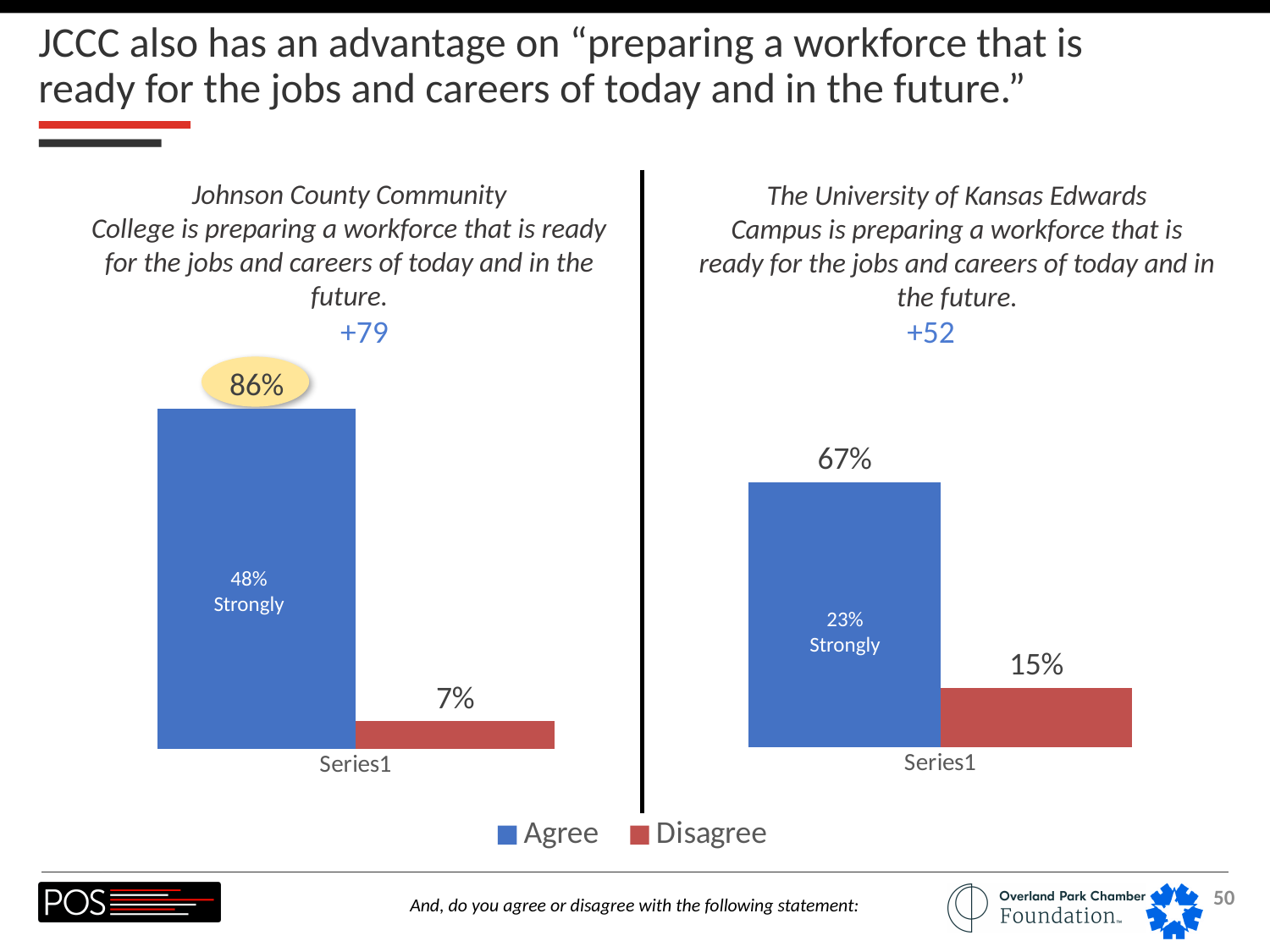
What kind of chart is used on this slide? Bar chart In the left chart (Johnson County Community College), what is the difference between the Agree and Disagree percentages? 79 percentage points In the right chart (The University of Kansas Edwards Campus), what percentage strongly agree? 23% In the right chart (The University of Kansas Edwards Campus), what percentage agree? 67% In the right chart (The University of Kansas Edwards Campus), what percentage disagree? 15% Which chart shows the higher Agree percentage, the left (Johnson County Community College) or the right (The University of Kansas Edwards Campus)? The left (Johnson County Community College) In the right chart (The University of Kansas Edwards Campus), which is larger, Agree or Disagree? Agree In the right chart (The University of Kansas Edwards Campus), what is the difference between the Agree and Disagree percentages? 52 percentage points In the left chart (Johnson County Community College), what percentage disagree? 7% In the left chart (Johnson County Community College), what percentage agree? 86% In the left chart (Johnson County Community College), what percentage strongly agree? 48% How many series does the legend list? 2